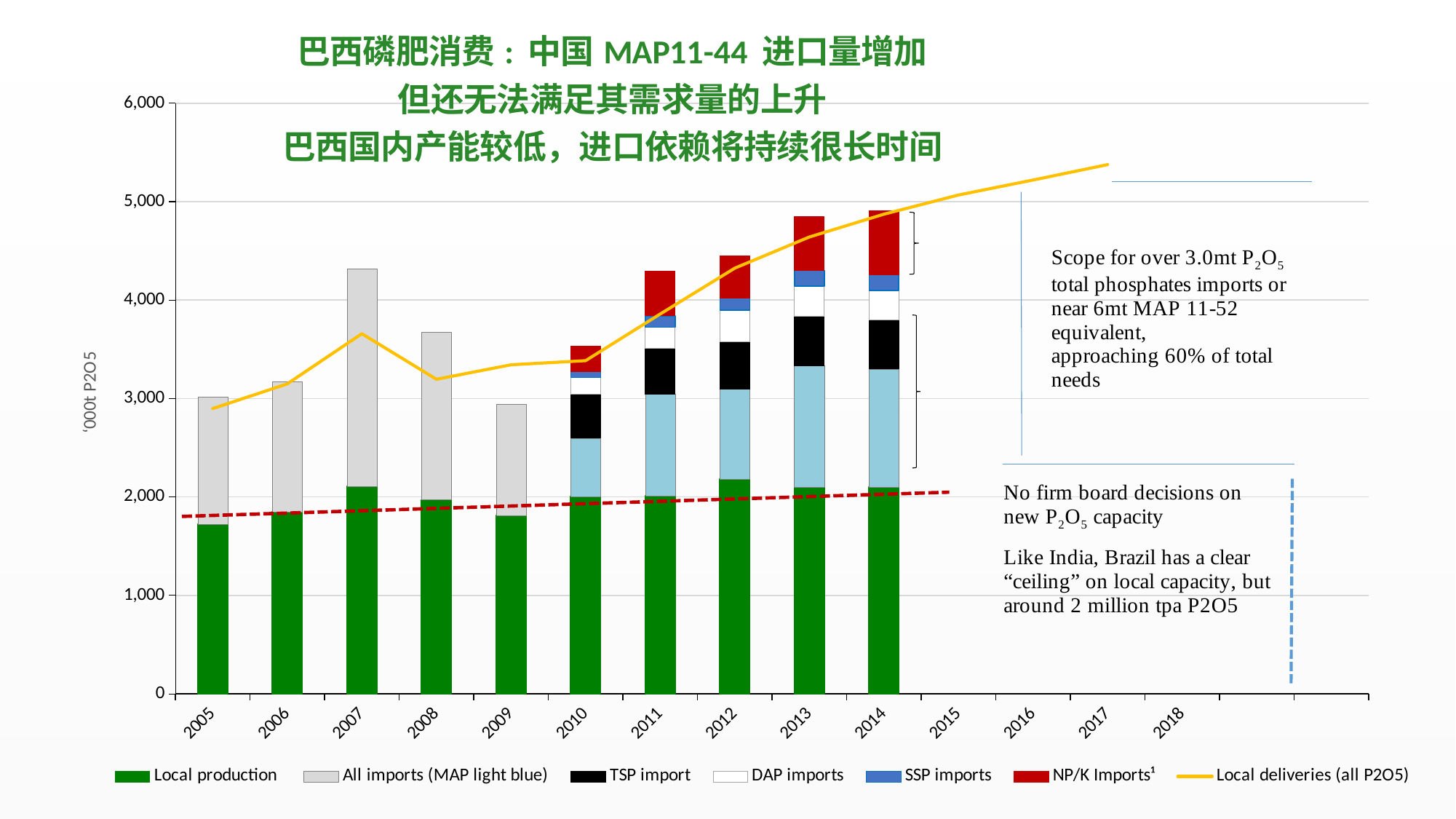
Is the Local deliveries (all P2O5) value for 2017 greater or less than 5,000? greater Is the Local deliveries (all P2O5) value for 2005 greater or less than 3,000? less What is the label on the vertical axis? '000t P2O5 Which year has the highest Local deliveries (all P2O5) value? 2017 How many years have stacked bars plotted? 10 How many series does the legend list? 7 Is the Local production value for 2012 greater or less than 2,000? greater Does the Local deliveries (all P2O5) line rise or fall from 2009 to 2017? rise What kind of chart is shown on the slide? Stacked bar chart with a line Which is larger, the total stacked bar for 2007 or for 2008? 2007